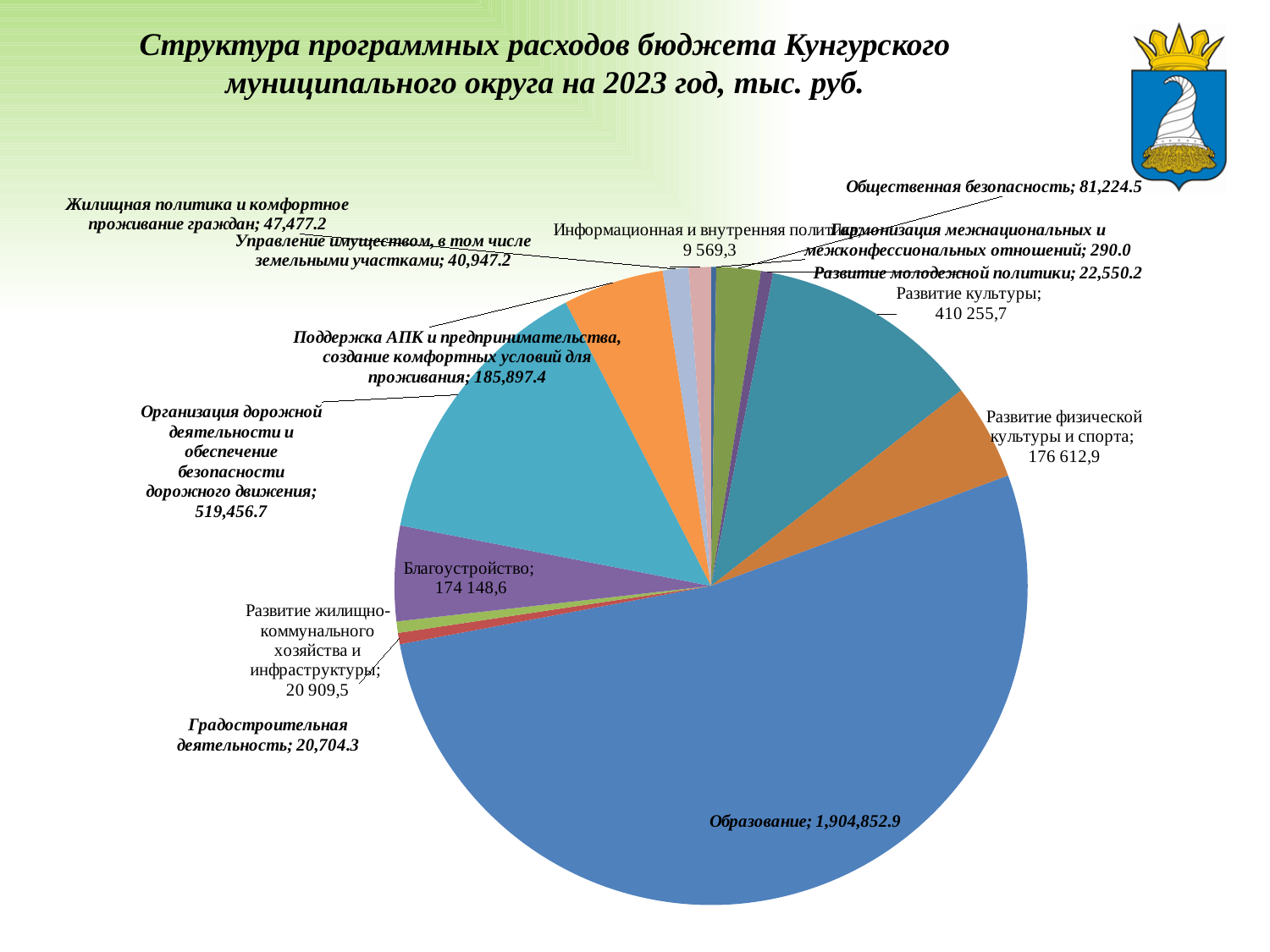
What is the value for Градостроительная деятельность? 20,704.3 What is the difference between Общественная безопасность and Жилищная политика и комфортное проживание граждан? 33,747.3 Which is larger: Развитие культуры or Развитие физической культуры и спорта? Развитие культуры What is the value for Благоустройство? 174 148,6 Which category has the smallest value? Гармонизация межнациональных и межконфессиональных отношений Which category has the largest slice of the pie? Образование What is the value for Общественная безопасность? 81,224.5 What kind of chart is shown on the slide? pie chart What is the value for Развитие культуры? 410 255,7 What is the difference between Образование and Организация дорожной деятельности и обеспечение безопасности дорожного движения? 1,385,396.2 What is the title of the chart? Структура программных расходов бюджета Кунгурского муниципального округа на 2023 год, тыс. руб. What is the value for Образование? 1,904,852.9